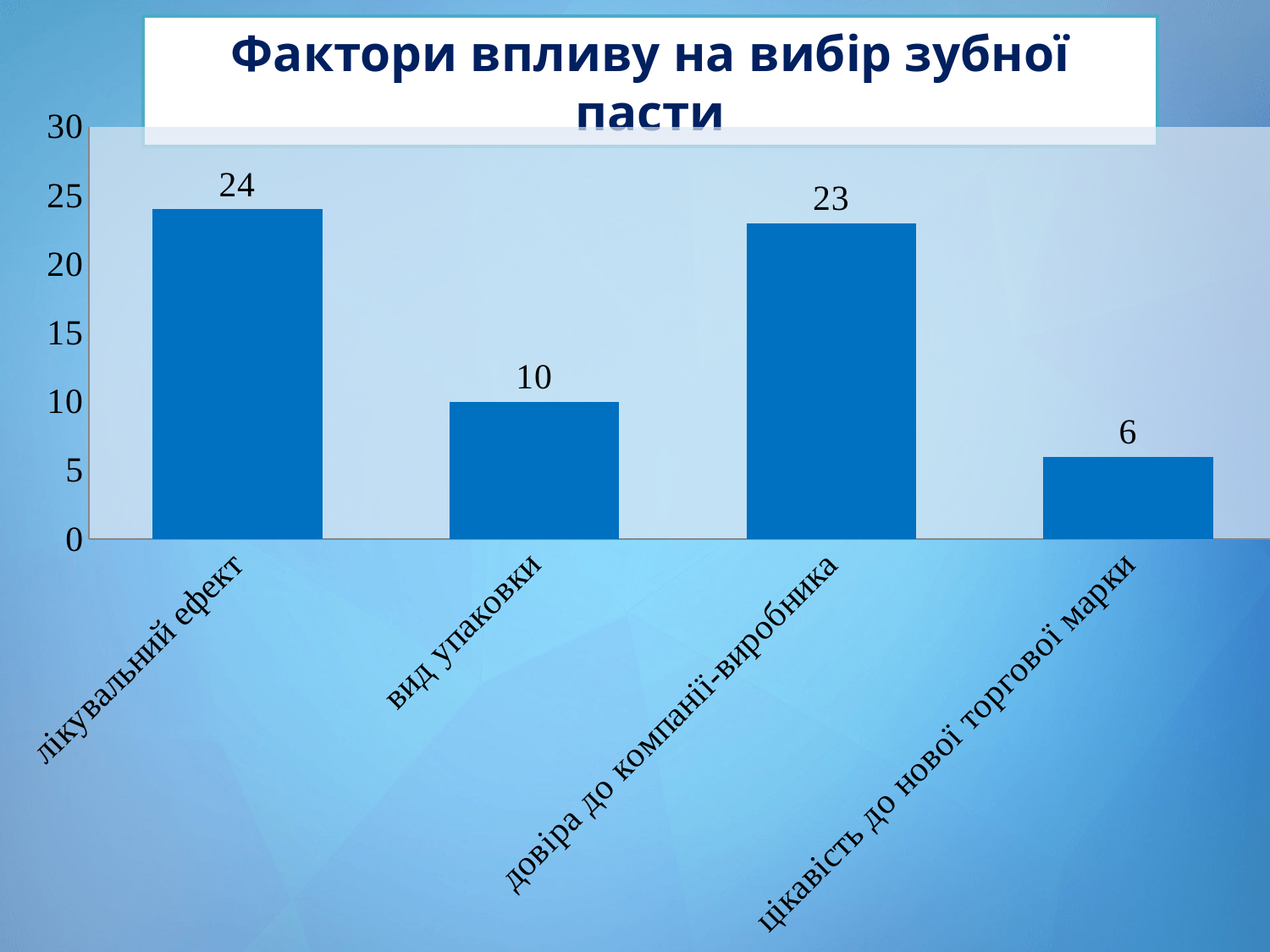
What is the title of the chart? Фактори впливу на вибір зубної пасти What is the value for лікувальний ефект? 24 What is the value for цікавість до нової торгової марки? 6 What is the value for вид упаковки? 10 Which category has the lowest value? цікавість до нової торгової марки Which is larger: the value for вид упаковки or the value for цікавість до нової торгової марки? вид упаковки How many categories are shown in the chart? 4 What is the value for довіра до компанії-виробника? 23 Which category has the highest value? лікувальний ефект What is the difference between the values for довіра до компанії-виробника and цікавість до нової торгової марки? 17 What kind of chart is shown on the slide? bar chart What is the difference between the values for лікувальний ефект and вид упаковки? 14